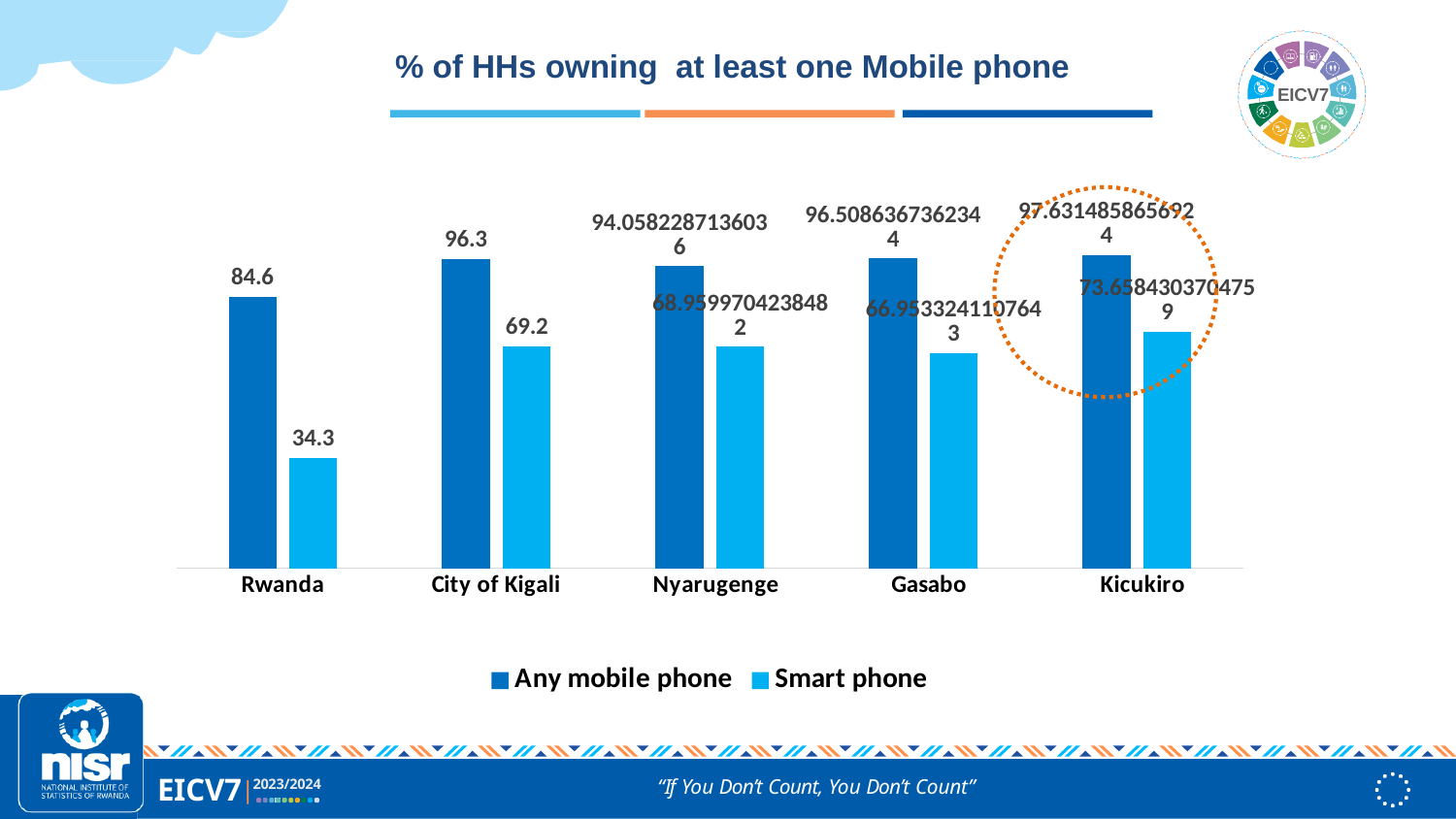
What is the difference between the Any mobile phone and Smart phone values for Rwanda? 50.3 Which category has the lowest Smart phone value? Rwanda What is the value for Any mobile phone in City of Kigali? 96.3 How many series does the legend list? 2 What is the value for Smart phone in Rwanda? 34.3 What is the difference between the Any mobile phone and Smart phone values for City of Kigali? 27.1 Which category has the highest Any mobile phone value? Kicukiro What is the value for Smart phone in City of Kigali? 69.2 What kind of chart is shown on the slide? Bar chart Which is larger, the Smart phone value for Kicukiro or for Gasabo? Kicukiro How many categories are shown on the x axis? 5 What is the value for Any mobile phone in Rwanda? 84.6